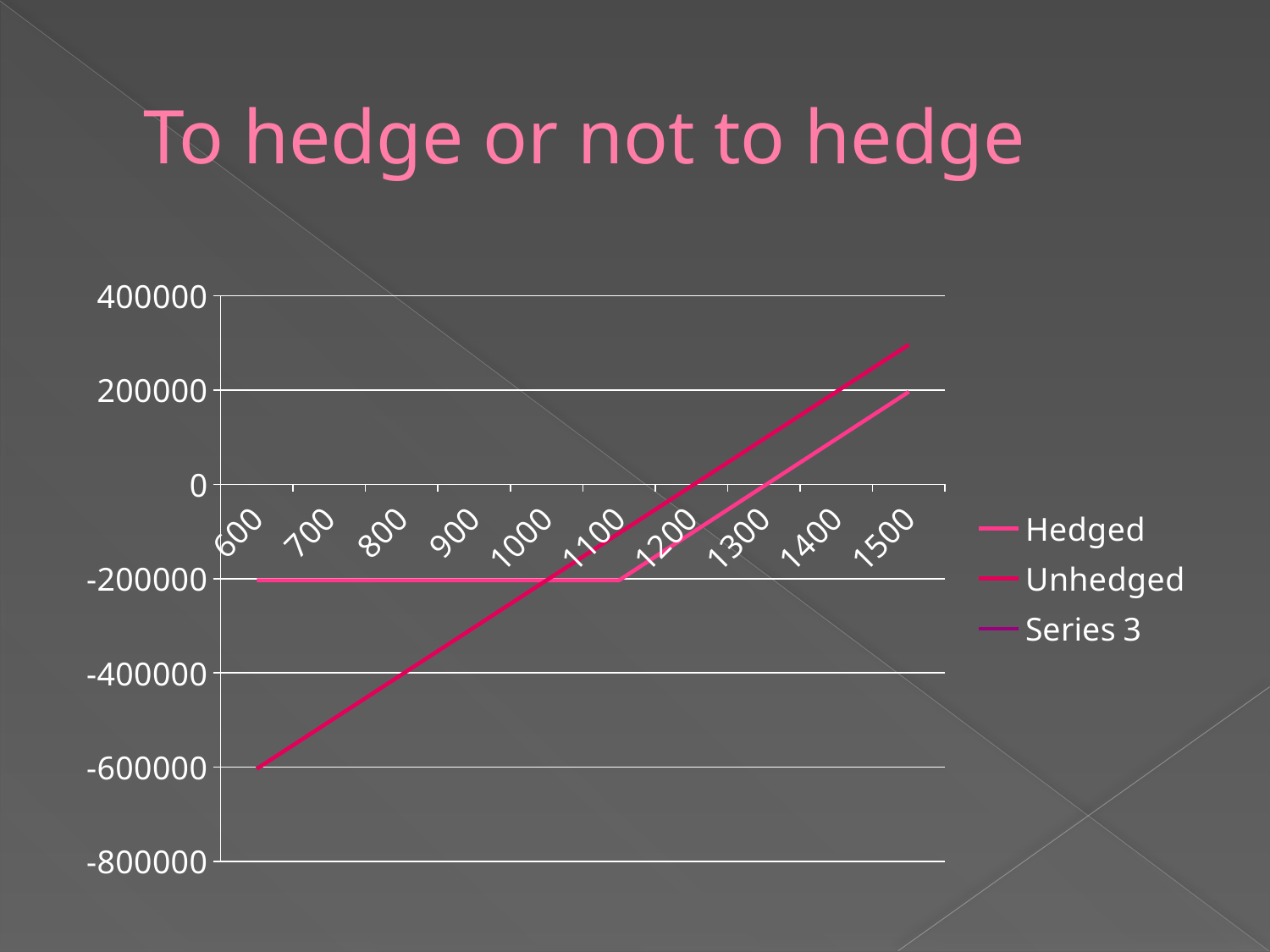
How many series does the legend list? 3 Is the value of the Unhedged series at 800 greater or less than -200000? less At 1500, which series has the higher value, Hedged or Unhedged? Unhedged At 600, which series has the higher value, Hedged or Unhedged? Hedged What kind of chart is shown on the slide? line chart Is the value of the Unhedged series at 1500 greater or less than 200000? greater Does the Unhedged series rise or fall as the x-axis values increase from 600 to 1500? rise How many x-axis categories are shown on the chart? 10 What is the title of the slide containing the chart? To hedge or not to hedge